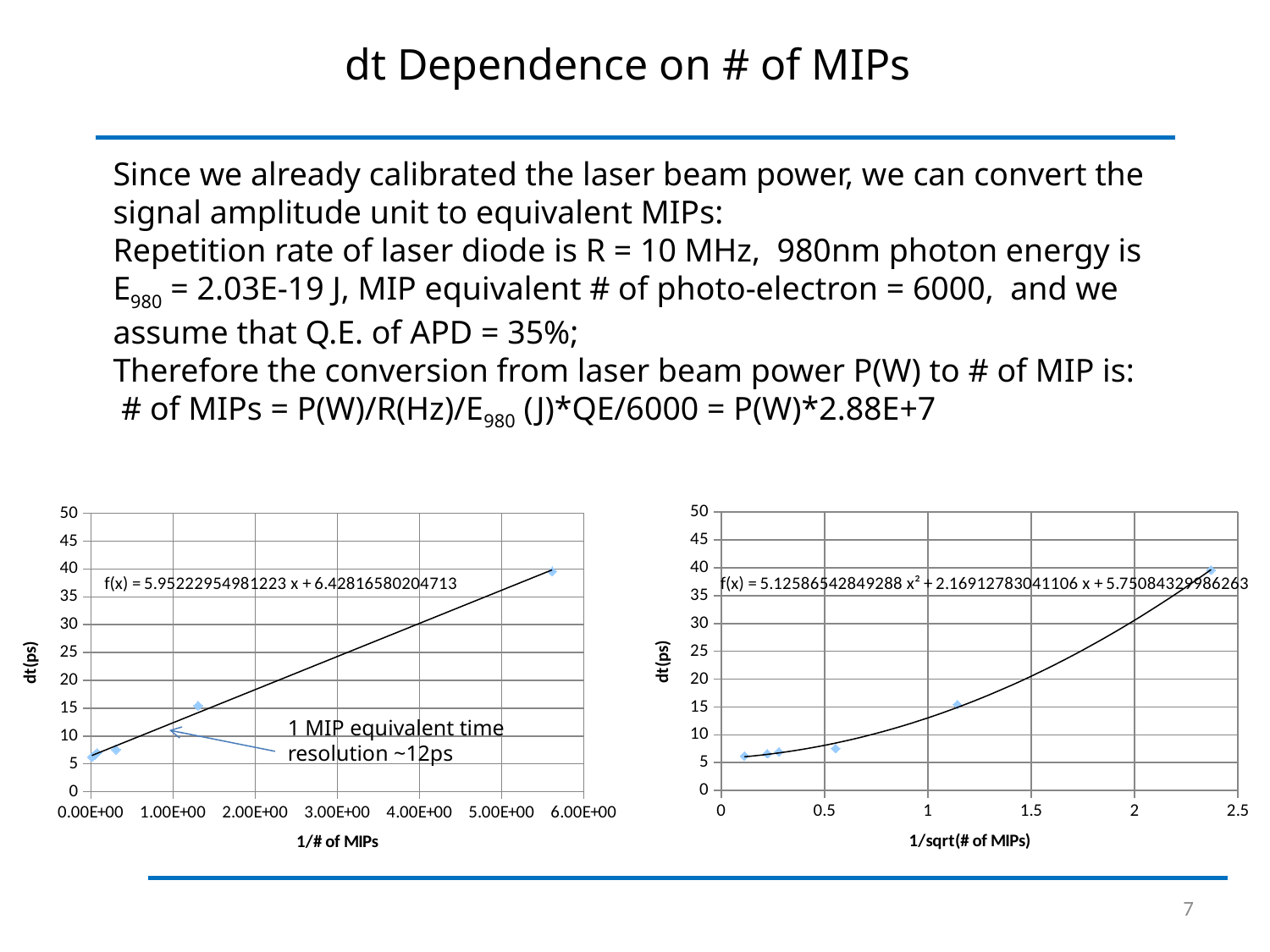
What kind of chart is the left chart on the slide? scatter chart In the left chart, what is the intercept term in the printed trendline equation f(x)? 6.42816580204713 In the right chart, what is the coefficient of x² in the printed trendline equation? 5.12586542849288 What is the x-axis title of the right chart? 1/sqrt(# of MIPs) What is the x-axis title of the left chart? 1/# of MIPs In the left chart, is the dt(ps) value of the rightmost data point greater or less than 35? greater In the left chart, is the dt(ps) value of the leftmost data point greater or less than 10? less What kind of chart is the right chart on the slide? scatter chart In the right chart, do the dt(ps) values rise or fall as 1/sqrt(# of MIPs) increases? rise In the left chart, do the dt(ps) values rise or fall as 1/# of MIPs increases? rise In the right chart, is the dt(ps) value of the rightmost data point greater or less than 35? greater